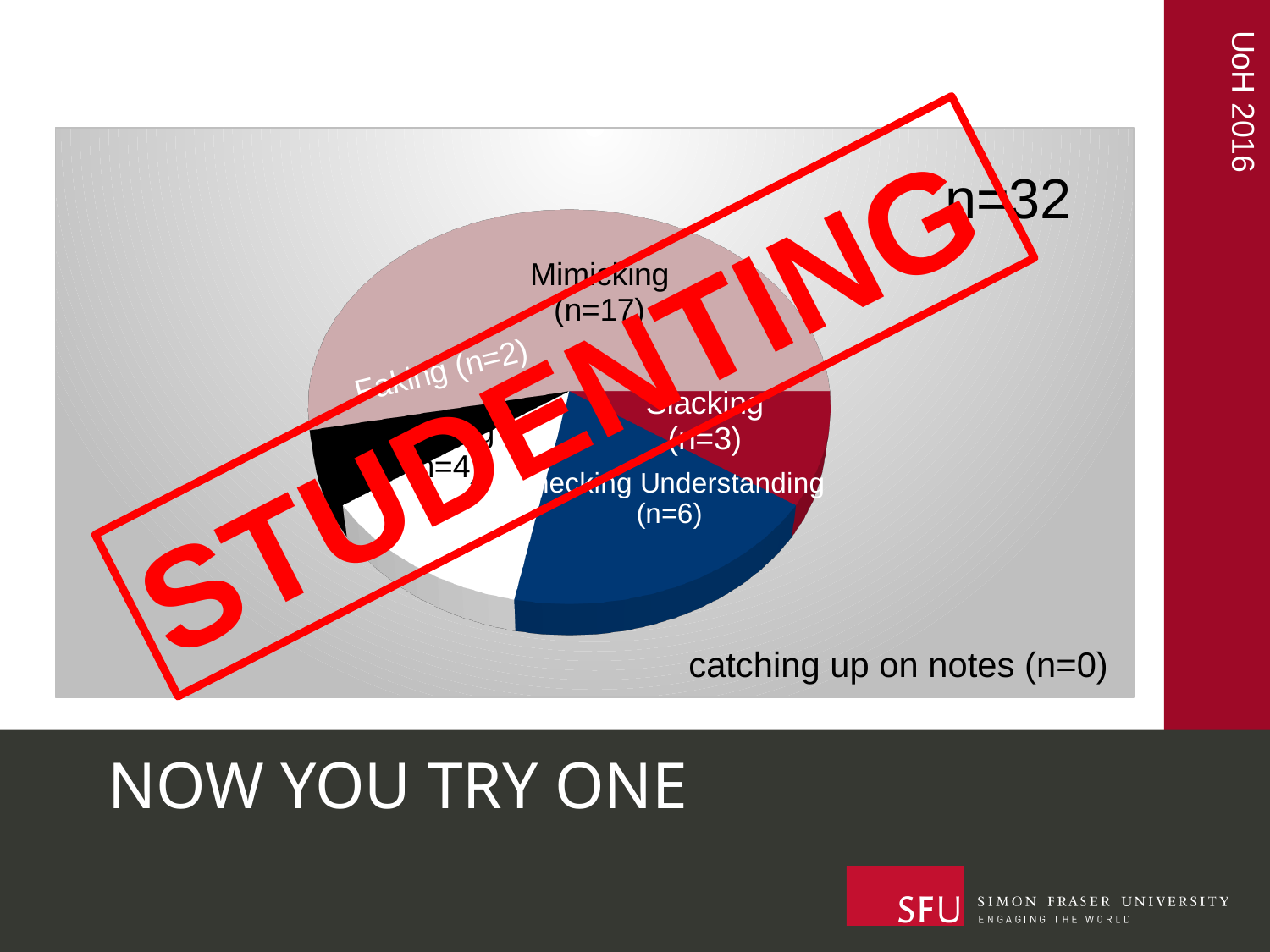
What is the difference between the n values for Mimicking and Checking Understanding? 11 Which category has the smallest n value? catching up on notes What is the n value for the Checking Understanding slice? 6 Which is larger, Mimicking or Checking Understanding? Mimicking What is the n value for catching up on notes? 0 Which is larger, Checking Understanding or Slacking? Checking Understanding What word is stamped in red across the chart? STUDENTING What total n is shown for the pie chart? 32 What is the n value for the Slacking slice? 3 What kind of chart is shown on the slide? pie chart What is the n value for the Mimicking slice? 17 Which category has the largest slice of the pie? Mimicking